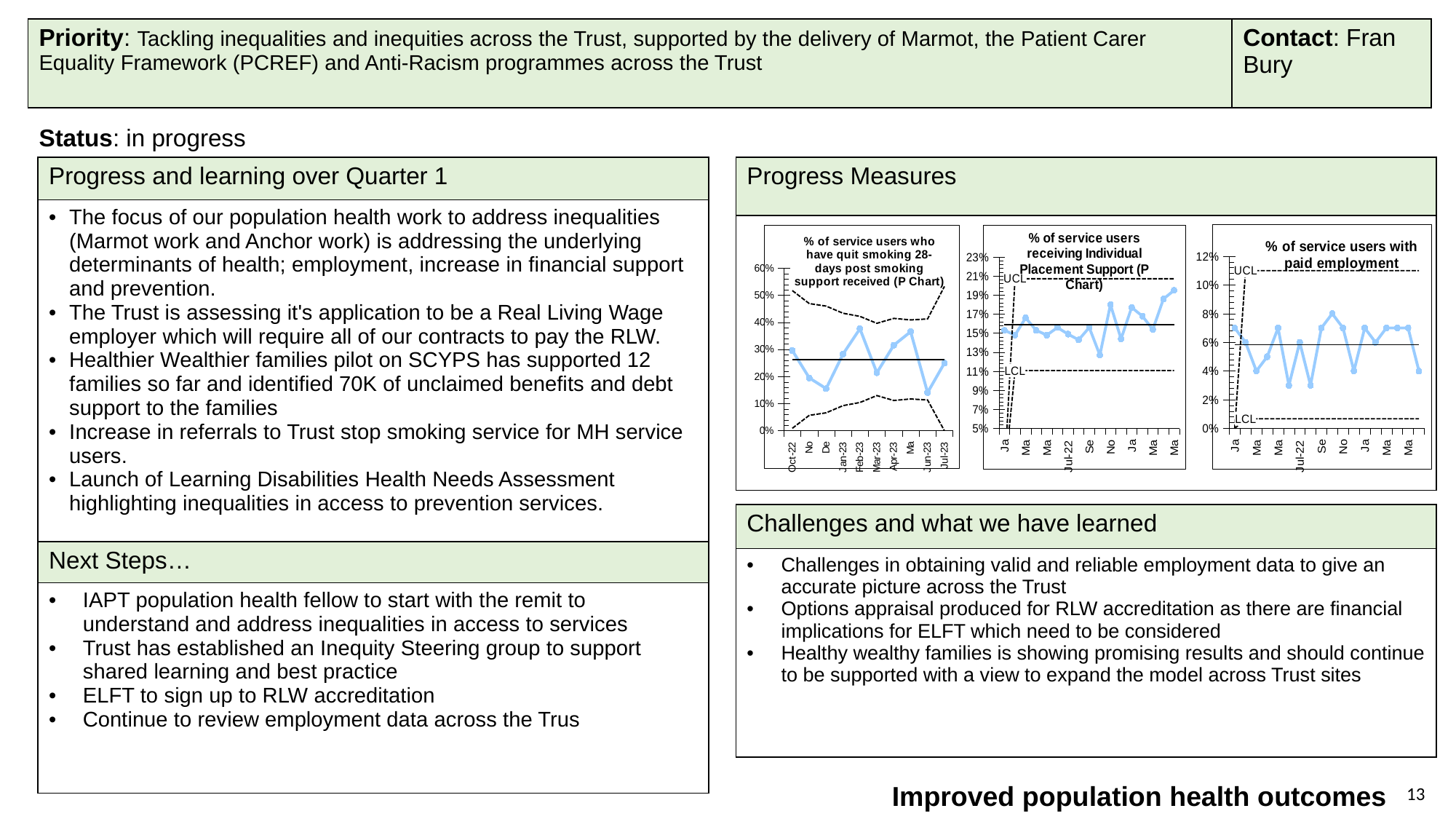
In the '% of service users with paid employment' chart, is the last plotted point greater or less than 6%? less In the '% of service users who have quit smoking' chart, how many months are plotted on the x axis? 10 In the '% of service users who have quit smoking' chart, is the value for Feb-23 greater or less than 30%? greater In the '% of service users who have quit smoking' chart, is the value for Jun-23 greater or less than 20%? less What is the highest tick shown on the y axis of the '% of service users who have quit smoking' chart? 60% In the '% of service users who have quit smoking' chart, which is larger, the value for Feb-23 or Mar-23? Feb-23 What kind of chart is the '% of service users with paid employment' chart? line chart What kind of chart is the '% of service users who have quit smoking 28-days post smoking support received (P Chart)'? line chart What is the title of the middle chart in the Progress Measures section? % of service users receiving Individual Placement Support (P Chart) In the '% of service users who have quit smoking' chart, which is larger, the value for Apr-23 or Jun-23? Apr-23